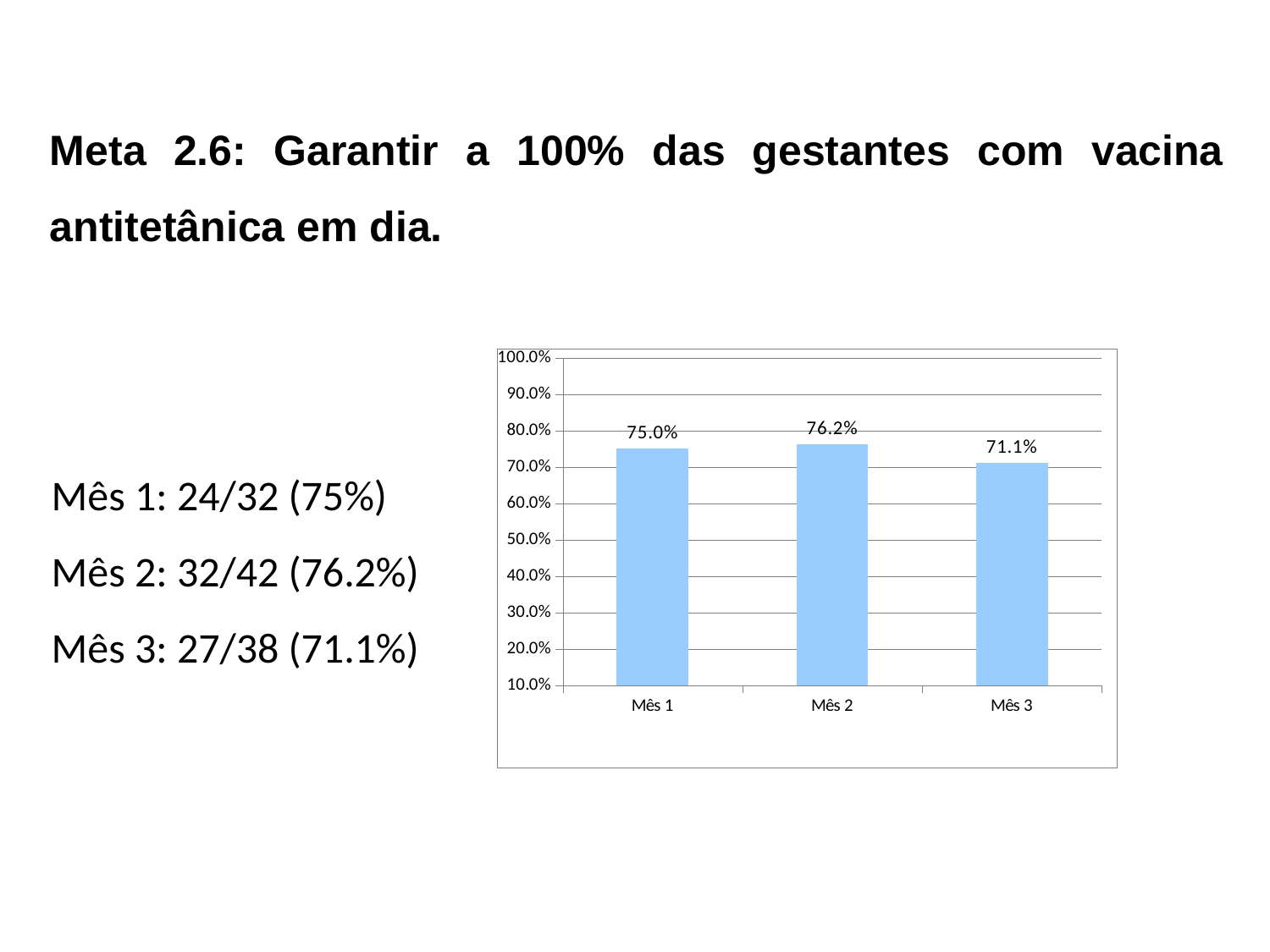
What is the value for Mês 1? 75.0% What is the value for Mês 3? 71.1% What is the highest value shown on the y axis? 100.0% What is the difference between the values for Mês 1 and Mês 3? 3.9% Is the value for Mês 3 greater or less than 80.0%? less What kind of chart is shown on the slide? bar chart What is the difference between the values for Mês 2 and Mês 3? 5.1% Which is larger, the value for Mês 1 or the value for Mês 3? Mês 1 What is the value for Mês 2? 76.2% Which month has the highest value? Mês 2 Which month has the lowest value? Mês 3 How many categories are shown on the x axis? 3